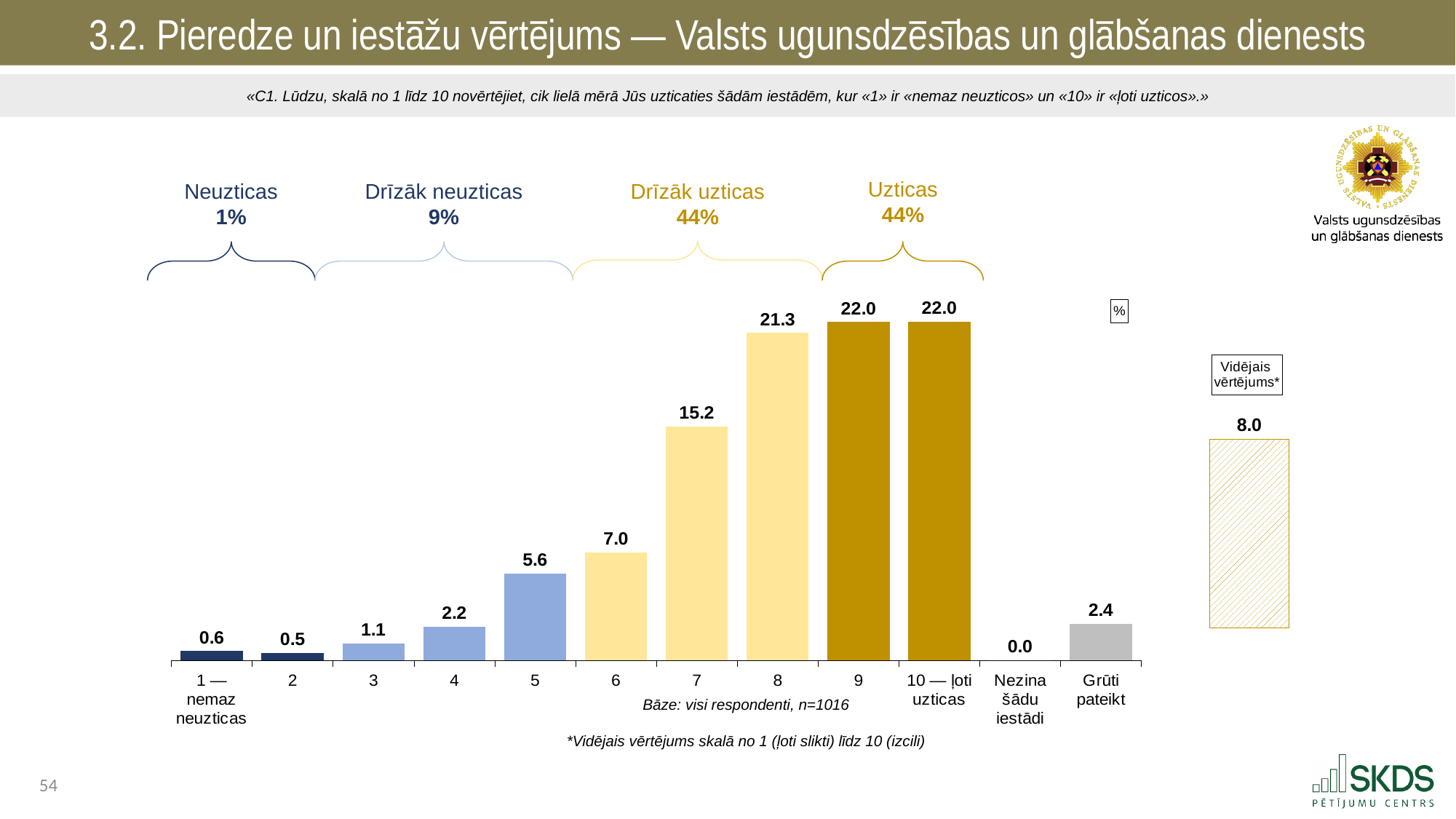
What is the difference between the values for rating 8 and rating 7? 6.1 What is the combined share shown for the 'Uzticas' group (ratings 9 and 10)? 44% What value is shown for the 'Grūti pateikt' category? 2.4 How many categories are shown on the x axis of the main bar chart? 12 What is the value of the 'Vidējais vērtējums*' bar on the right? 8.0 What is the sample size stated below the chart? n=1016 What percentage of respondents gave a rating of 8? 21.3 What kind of chart is used on this slide? bar chart Which is larger, the value for rating 5 or the value for rating 6? rating 6 What is the value shown for the rating 7 bar? 15.2 Do the values rise or fall from rating 3 to rating 9? rise Which rating category has the lowest value in the main bar chart? Nezina šādu iestādi